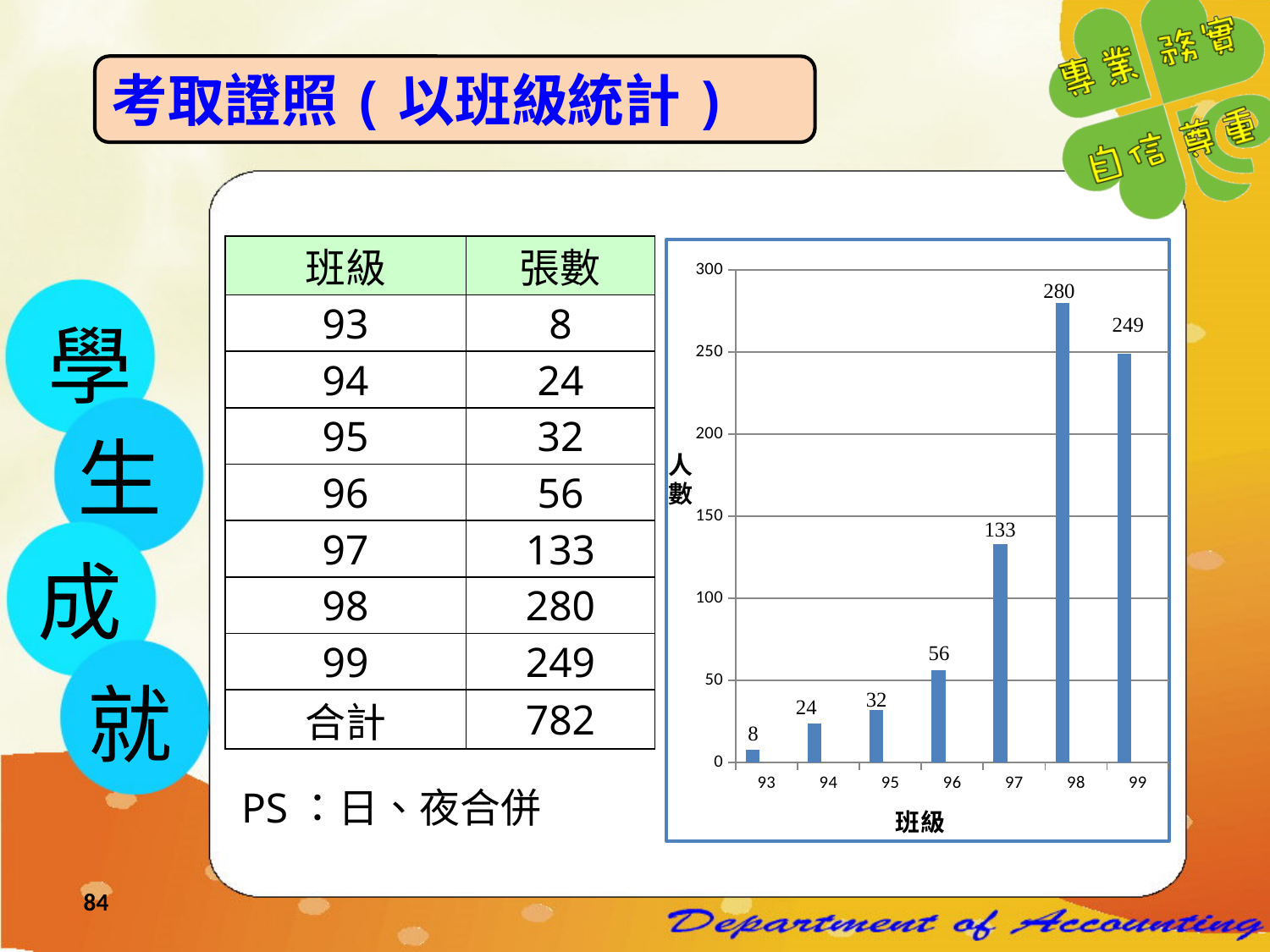
Which is larger, the value for class 95 or the value for class 96? 96 How many classes are shown on the x axis of the chart? 7 What is the difference between the values for class 98 and class 99? 31 Is the value for class 97 greater or less than 150? less Which class has the lowest value in the chart? 93 What kind of chart is shown on the slide? bar chart What is the value for class 93 in the chart? 8 What is the difference between the values for class 97 and class 96? 77 Which class has the highest value in the chart? 98 What is the value for class 99 in the chart? 249 What is the value for class 97 in the chart? 133 What is the x-axis title of the chart? 班級